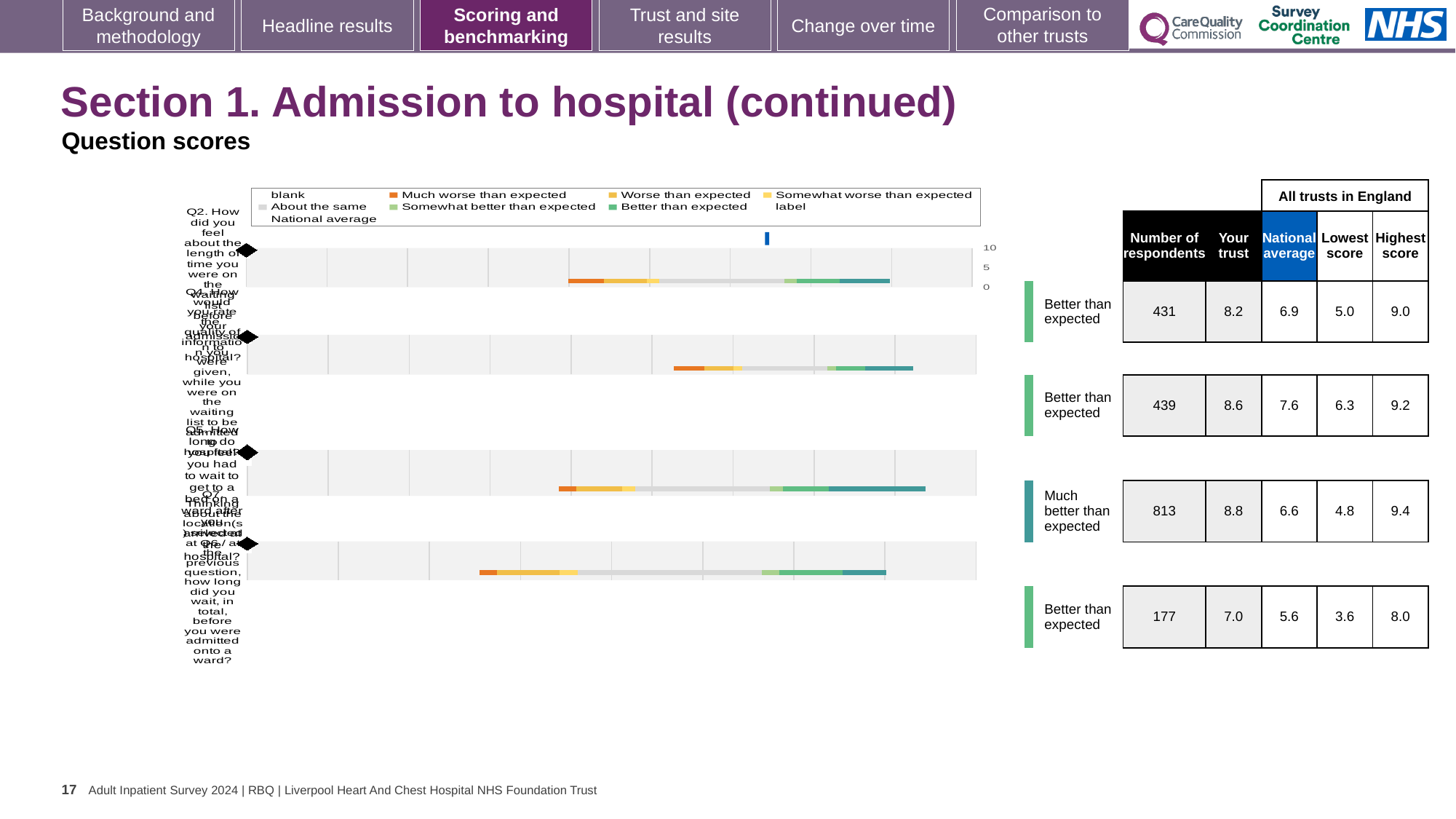
Which question has the highest 'Your trust' score? Q5 (8.8) How many questions are plotted on the chart? 4 Is the 'Your trust' score for Q7 greater or less than 5? greater What is the highest score across all trusts in England for Q7 (the fourth row)? 8.0 Which has the higher national average, Q4 or Q5? Q4 What is the 'Your trust' score for Q5 (the third row of the chart)? 8.8 What is the lowest score across all trusts in England for Q5 (the third row)? 4.8 What benchmark category is given for Q5 (the third row)? Much better than expected How many respondents are shown for Q2 (the first row of the chart)? 431 Which question has the lowest 'Your trust' score? Q7 (7.0) By how much does the 'Your trust' score for Q2 exceed the national average for Q2? 1.3 Which question has the most respondents? Q5 (813)